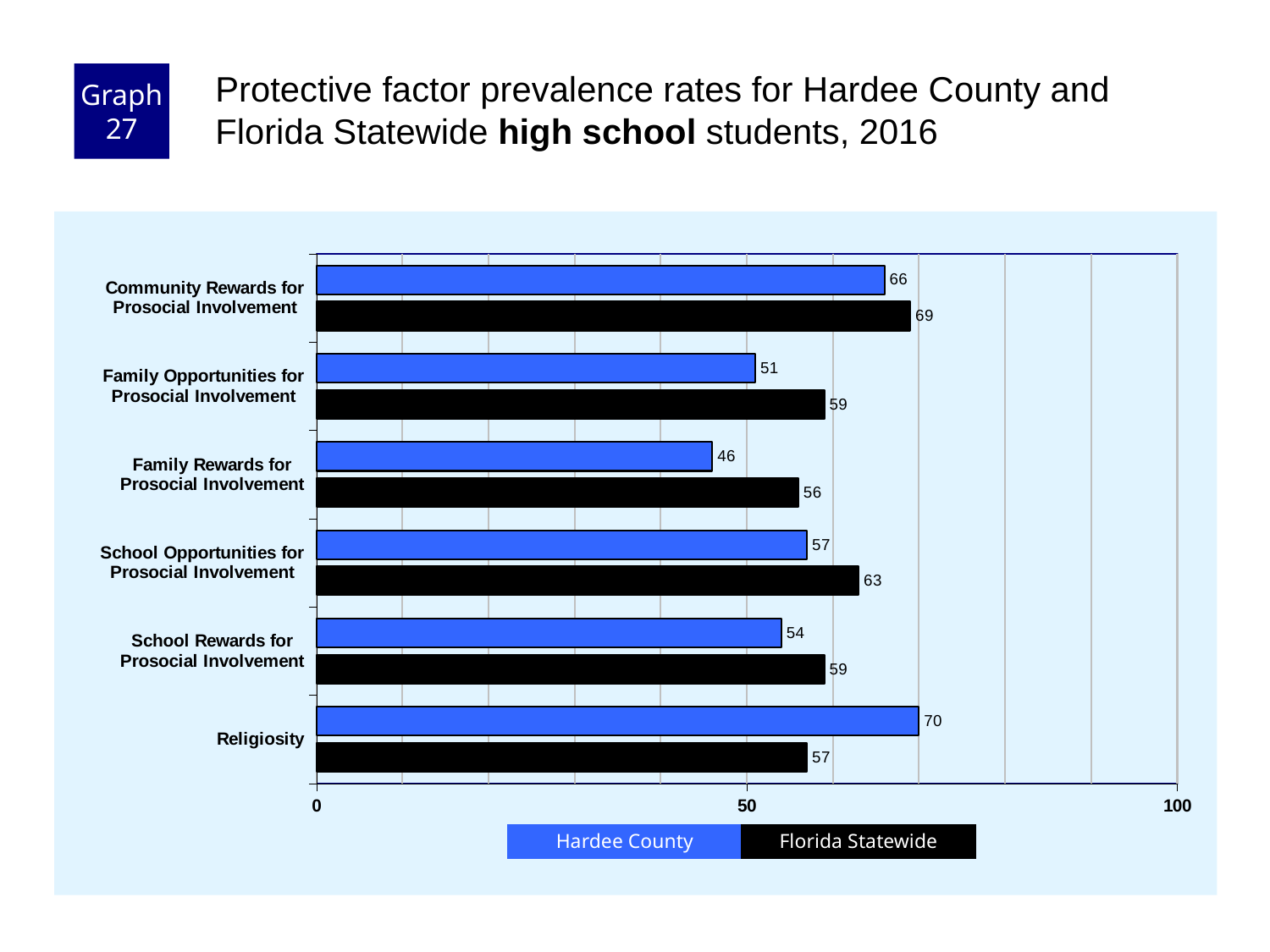
What is the Hardee County value for Family Rewards for Prosocial Involvement? 46 What is the difference between the Florida Statewide and Hardee County values for Family Opportunities for Prosocial Involvement? 8 What is the Florida Statewide value for Family Opportunities for Prosocial Involvement? 59 What is the Hardee County value for Religiosity? 70 Which category has the lowest Hardee County value? Family Rewards for Prosocial Involvement Which category has the highest Florida Statewide value? Community Rewards for Prosocial Involvement Is the Hardee County value for School Opportunities for Prosocial Involvement greater or less than 50? greater What colour are the Florida Statewide bars? black What kind of chart is shown on the slide? bar chart For Religiosity, which is larger: the Hardee County value or the Florida Statewide value? Hardee County How many series does the legend list? 2 How many categories are shown on the chart? 6